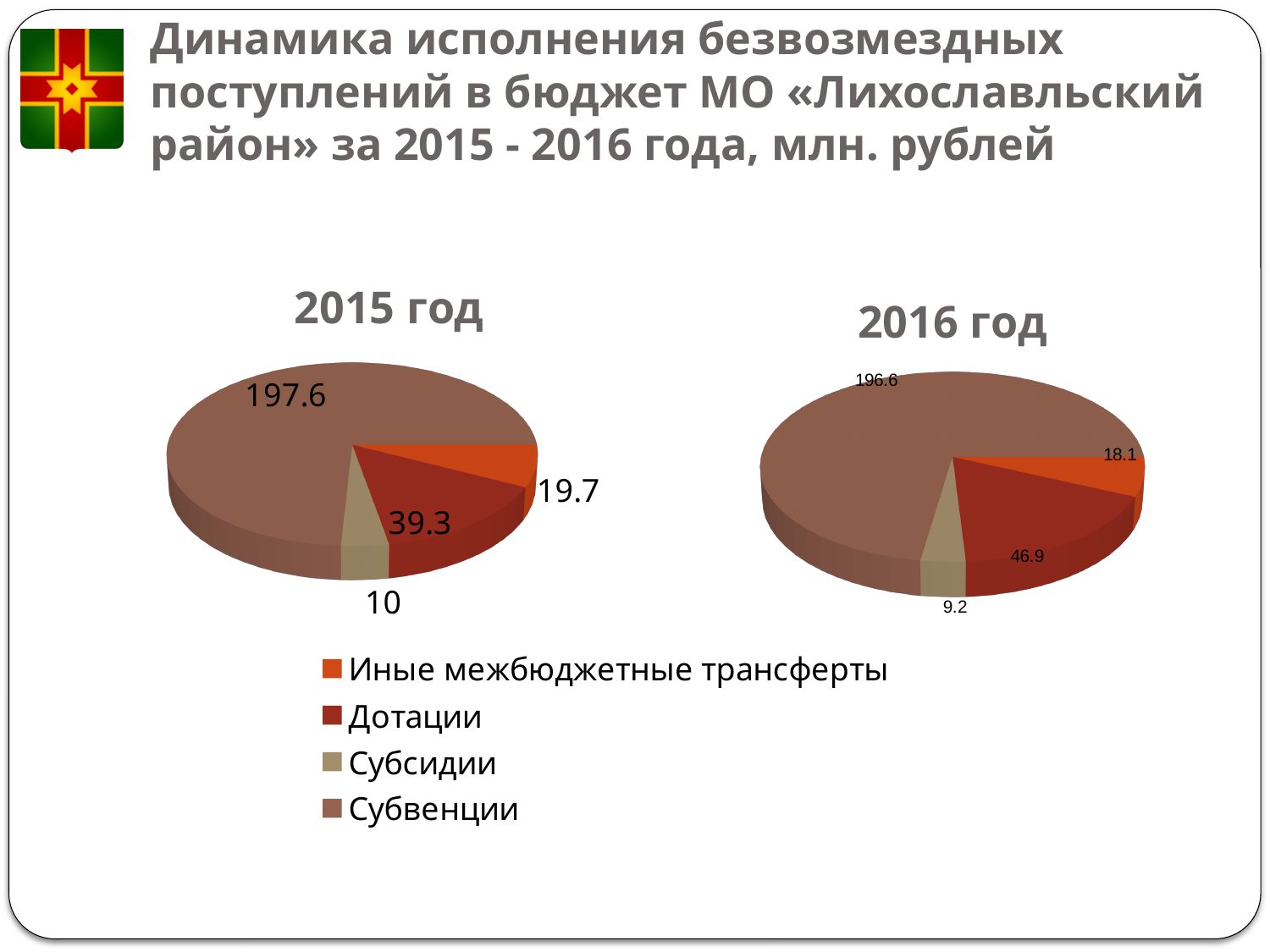
How many entries does the legend list? 4 Which legend entry is shown in orange? Иные межбюджетные трансферты In the "2015 год" chart, which category has the smallest slice? Субсидии What type of chart is the "2016 год" chart? Pie chart In the "2015 год" chart, what is the value for Субсидии? 10 In the "2016 год" chart, which category has the largest slice? Субвенции What is the difference between the Дотации values in the "2016 год" chart and the "2015 год" chart? 7.6 In the "2016 год" chart, what is the value for Дотации? 46.9 How many slices does the "2015 год" pie chart have? 4 In the "2015 год" chart, what is the value for Субвенции? 197.6 In the "2016 год" chart, what is the value for Иные межбюджетные трансферты? 18.1 Which is larger: Иные межбюджетные трансферты in the "2015 год" chart or in the "2016 год" chart? 2015 год